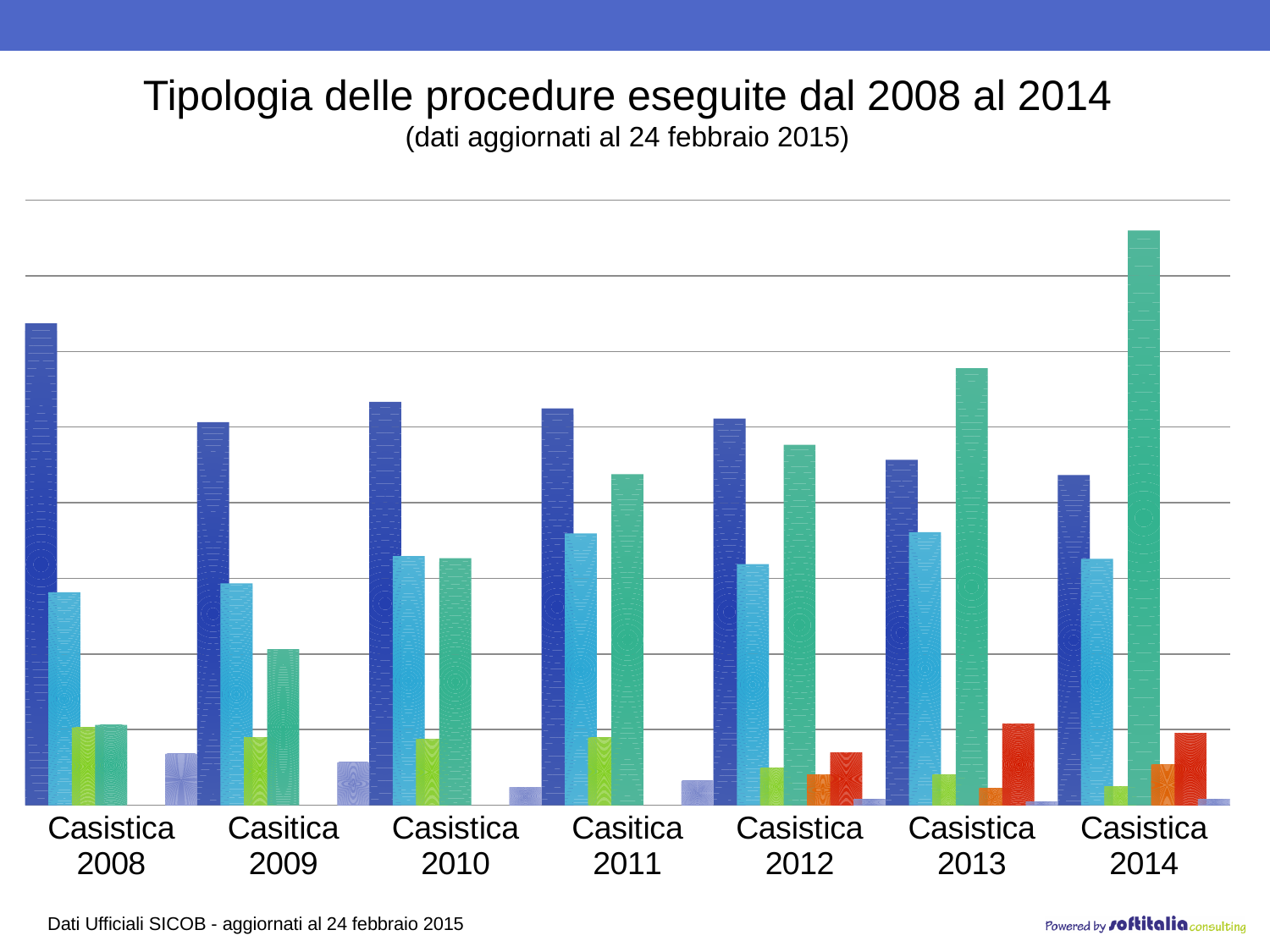
In which category is the dark blue bar the tallest? Casistica 2008 What is the title of the chart on the slide? Tipologia delle procedure eseguite dal 2008 al 2014 How many bars are in the Casistica 2008 group? 5 Which category contains the tallest bar in the whole chart? Casistica 2014 In the Casistica 2008 group, which is larger: the dark blue bar or the light blue bar? the dark blue bar Do the teal green bars rise or fall from Casistica 2008 to Casistica 2014? rise What subtitle appears under the chart title? (dati aggiornati al 24 febbraio 2015) In which category is the teal green bar the shortest? Casistica 2008 How many categories (year groups) are shown along the x axis? 7 How many bars are in the Casistica 2014 group? 7 In the Casistica 2014 group, which is larger: the dark blue bar or the teal green bar? the teal green bar What kind of chart is shown on the slide? bar chart